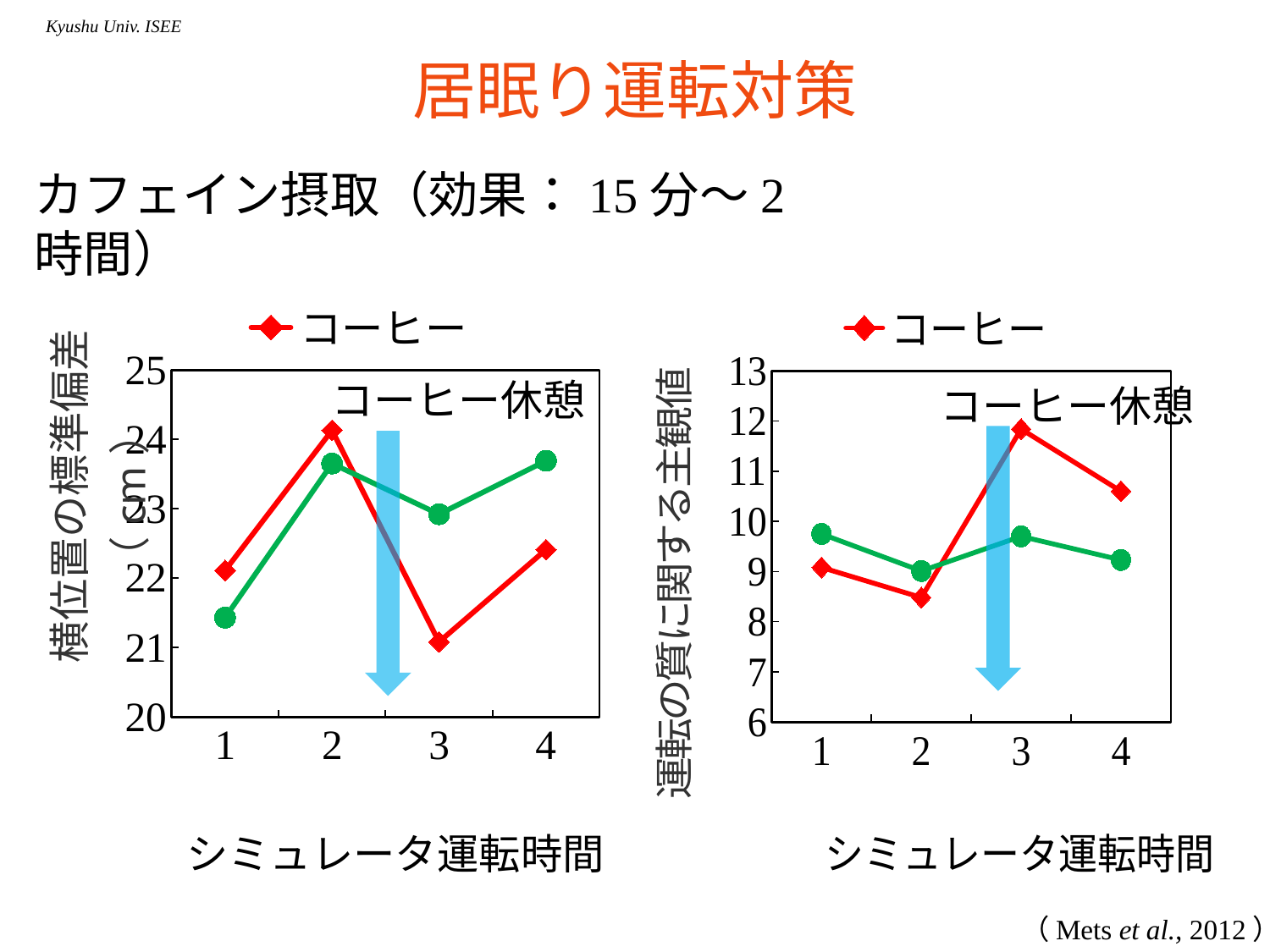
In the left chart (横位置の標準偏差), at which シミュレータ運転時間 is the コーヒー (red) series highest? 2 In the right chart (運転の質に関する主観値), is the コーヒー value at time 3 greater or less than 11? greater In the right chart (運転の質に関する主観値), does the コーヒー series rise or fall from time 3 to time 4? fall In the left chart (横位置の標準偏差), at time 3, which series is higher: the red コーヒー line or the green line? the green line In the left chart (横位置の標準偏差), at which シミュレータ運転時間 is the コーヒー (red) series lowest? 3 In the left chart (横位置の標準偏差), is the コーヒー value at time 2 greater or less than 23? greater In the right chart (運転の質に関する主観値), is the コーヒー value at time 2 greater or less than 9? less In the right chart (運転の質に関する主観値), at which シミュレータ運転時間 is the コーヒー (red) series highest? 3 What is the name of the series listed in the legend of the right chart? コーヒー What kind of chart is the left chart (横位置の標準偏差)? line chart How many points along the x axis (シミュレータ運転時間) does the left chart show? 4